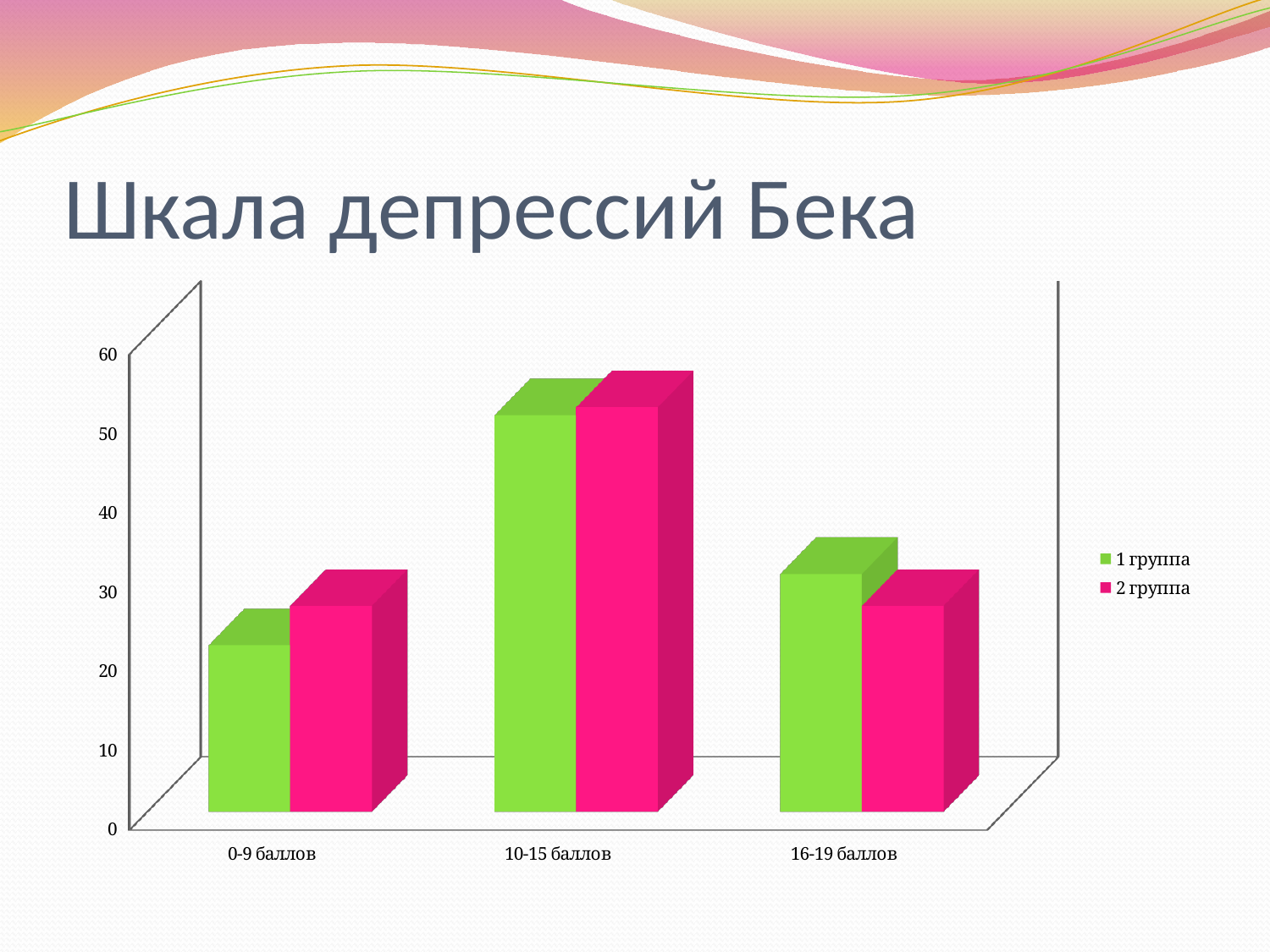
For the series 2 группа, which category has the highest value? 10-15 баллов For the series 1 группа, which category has the lowest value? 0-9 баллов In the 0-9 баллов category, which series has the larger value, 1 группа or 2 группа? 2 группа What is the title of the slide with the chart? Шкала депрессий Бека Is the value for 2 группа in the 10-15 баллов category greater or less than 40? greater How many categories are shown on the x axis? 3 Which colour represents the series 2 группа in the legend? pink What kind of chart is shown on the slide? bar chart Is the value for 1 группа in the 0-9 баллов category greater or less than 30? less Is the value for 1 группа in the 16-19 баллов category greater or less than 40? less For the series 1 группа, which category has the highest value? 10-15 баллов How many series does the legend list? 2